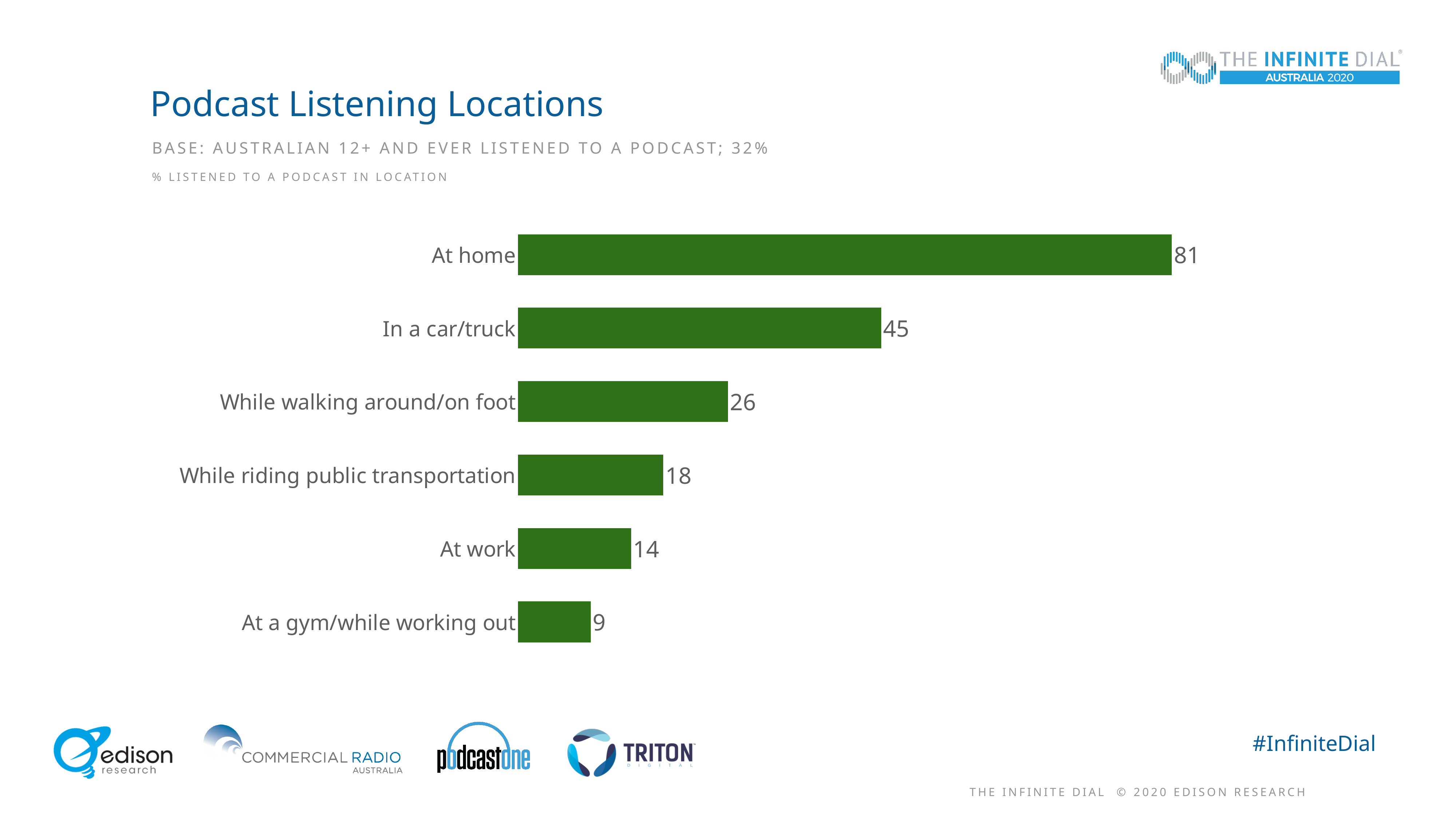
Which is larger, the value for While riding public transportation or the value for At work? While riding public transportation How many locations are shown in the chart? 6 What kind of chart is shown on the slide? Bar chart What is the value for In a car/truck? 45 What is the value for At a gym/while working out? 9 Which location has the lowest value? At a gym/while working out What is the difference between the values for While walking around/on foot and At work? 12 What is the value for While riding public transportation? 18 Which location has the highest value? At home What is the title of the chart? Podcast Listening Locations What is the value for At home? 81 What is the difference between the values for At home and In a car/truck? 36